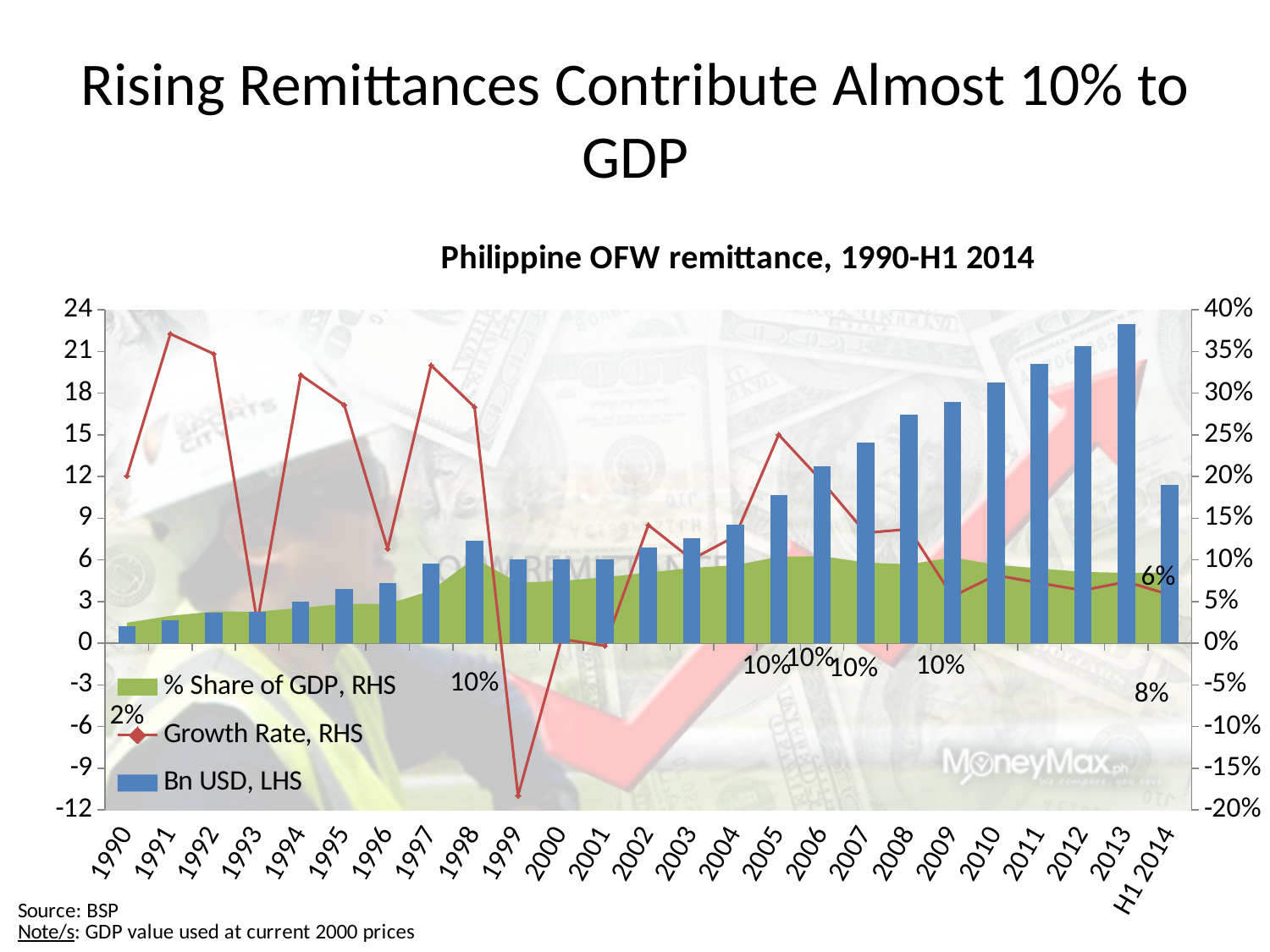
Which has the larger Bn USD bar, 2013 or H1 2014? 2013 How many time periods are shown along the x axis? 25 How many series does the legend list? 3 In which year is the Bn USD bar the shortest? 1990 Is the Bn USD value for 2013 greater or less than 21? greater Which axis does the Bn USD series use according to the legend? LHS In which year does the Growth Rate line reach its highest point? 1991 What kind of chart is shown on the slide? A combination chart with bars, a line and an area In which year does the Growth Rate line reach its lowest point? 1999 Do the Bn USD bars generally rise or fall from 1990 to 2013? rise Is the Bn USD value for 1990 greater or less than 3? less In which year is the Bn USD bar the tallest? 2013